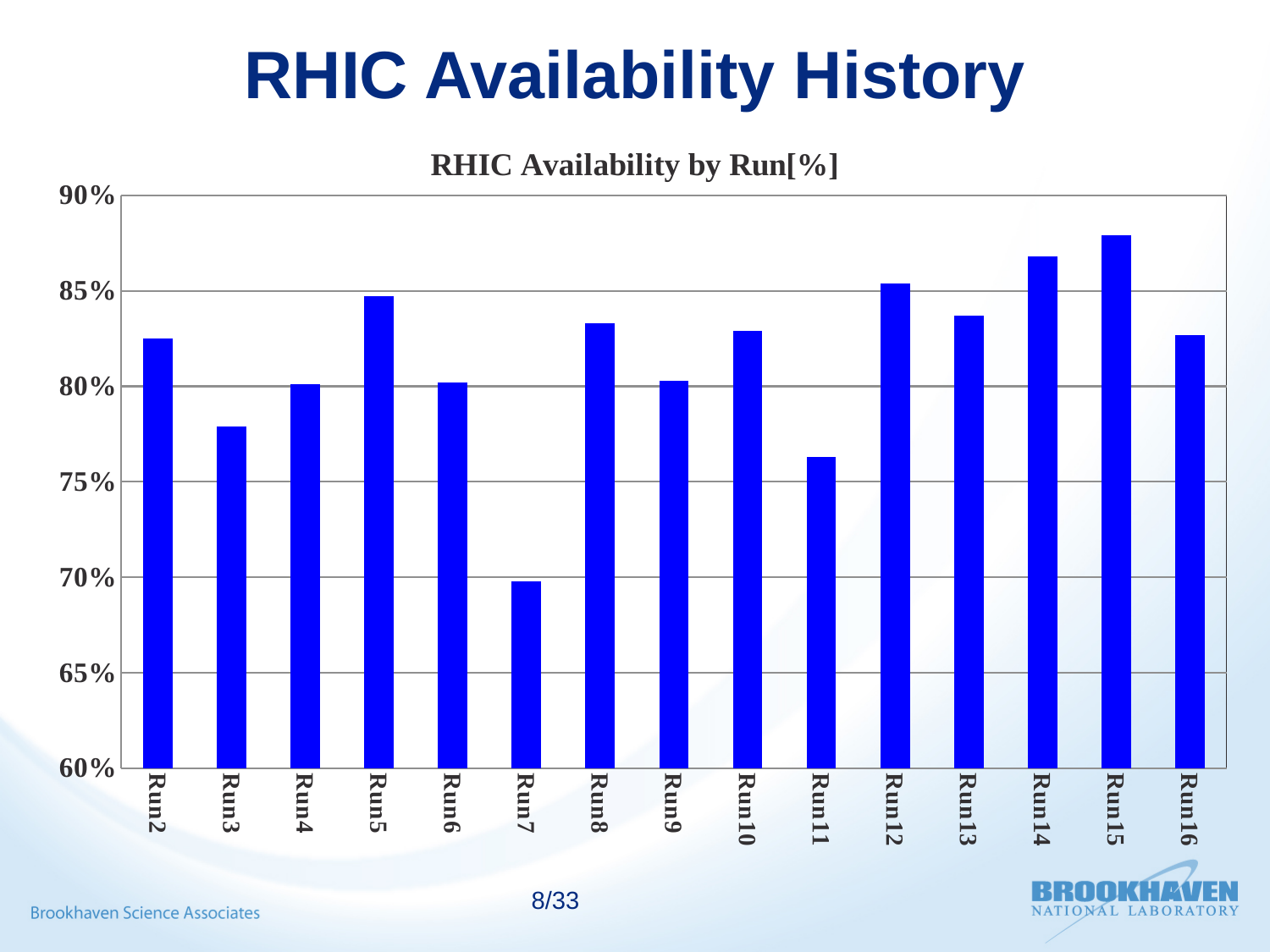
Which has the higher availability, Run3 or Run5? Run5 Is the value for Run14 greater or less than 85%? greater How many runs are plotted on the chart? 15 Which run has the highest availability? Run15 Which has the higher availability, Run11 or Run12? Run12 Is the value for Run11 greater or less than 80%? less What is the lowest value shown on the vertical axis? 60% What kind of chart is shown on the slide? Bar chart Is the value for Run7 greater or less than 75%? less Which run has the lowest availability? Run7 What is the title of the chart? RHIC Availability by Run[%]